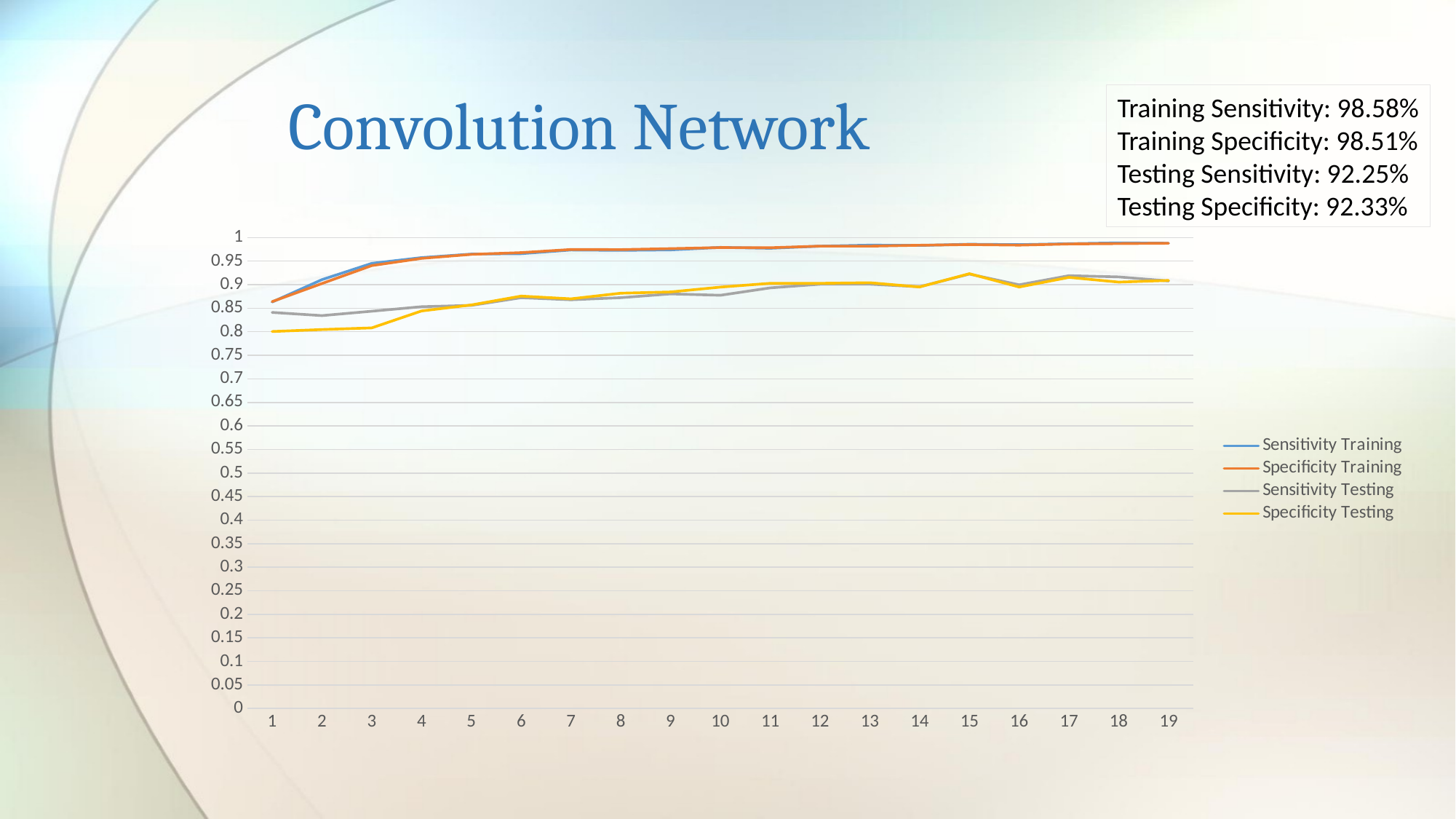
At x = 1, which is larger: Specificity Training or Specificity Testing? Specificity Training Which series has the lowest value at x = 1? Specificity Testing Is the value of Specificity Testing at x = 15 greater or less than 0.9? greater What colour is the Specificity Testing line? yellow How many points are plotted along the x axis for each series? 19 What kind of chart is shown on the slide? line chart How many series does the legend list? 4 At x = 3, which is larger: Sensitivity Testing or Specificity Testing? Sensitivity Testing Is the value of Specificity Testing at x = 1 greater or less than 0.85? less Is the value of Specificity Training at x = 1 greater or less than 0.9? less Does the Sensitivity Training line rise or fall from x = 1 to x = 19? rise